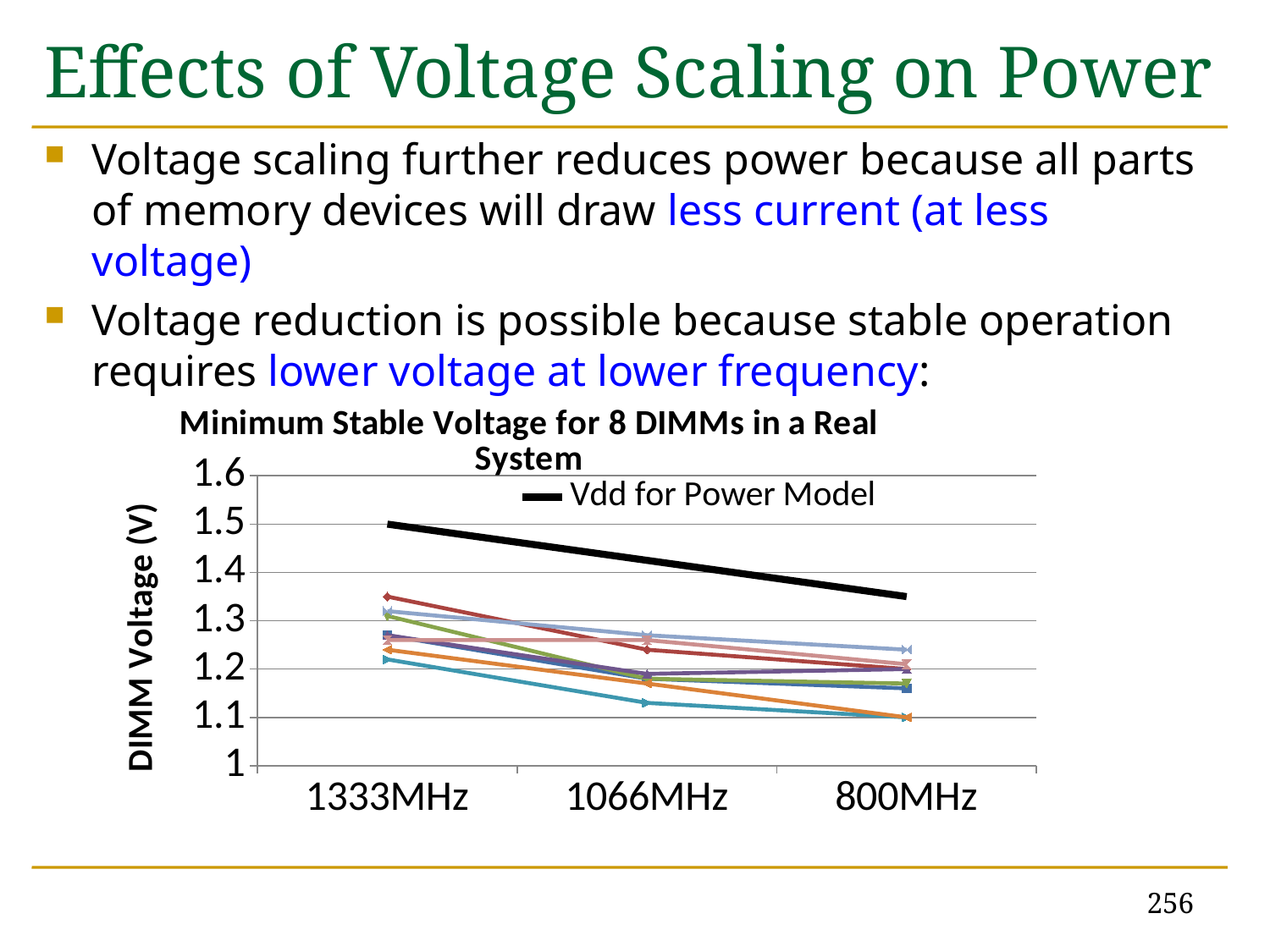
How many series does the legend list? 1 Does Vdd for Power Model rise or fall from 1333MHz to 800MHz? fall Which is larger, Vdd for Power Model at 1333MHz or at 800MHz? 1333MHz How many frequency categories are shown on the x axis? 3 What is the value of Vdd for Power Model at 1333MHz? 1.5 Is the value of Vdd for Power Model at 1066MHz greater or less than 1.5? less What is the title of the chart? Minimum Stable Voltage for 8 DIMMs in a Real System At which frequency is Vdd for Power Model highest? 1333MHz What kind of chart is shown on the slide? line chart Is the value of Vdd for Power Model at 800MHz greater or less than 1.4? less At which frequency is Vdd for Power Model lowest? 800MHz What is the label of the vertical axis? DIMM Voltage (V)